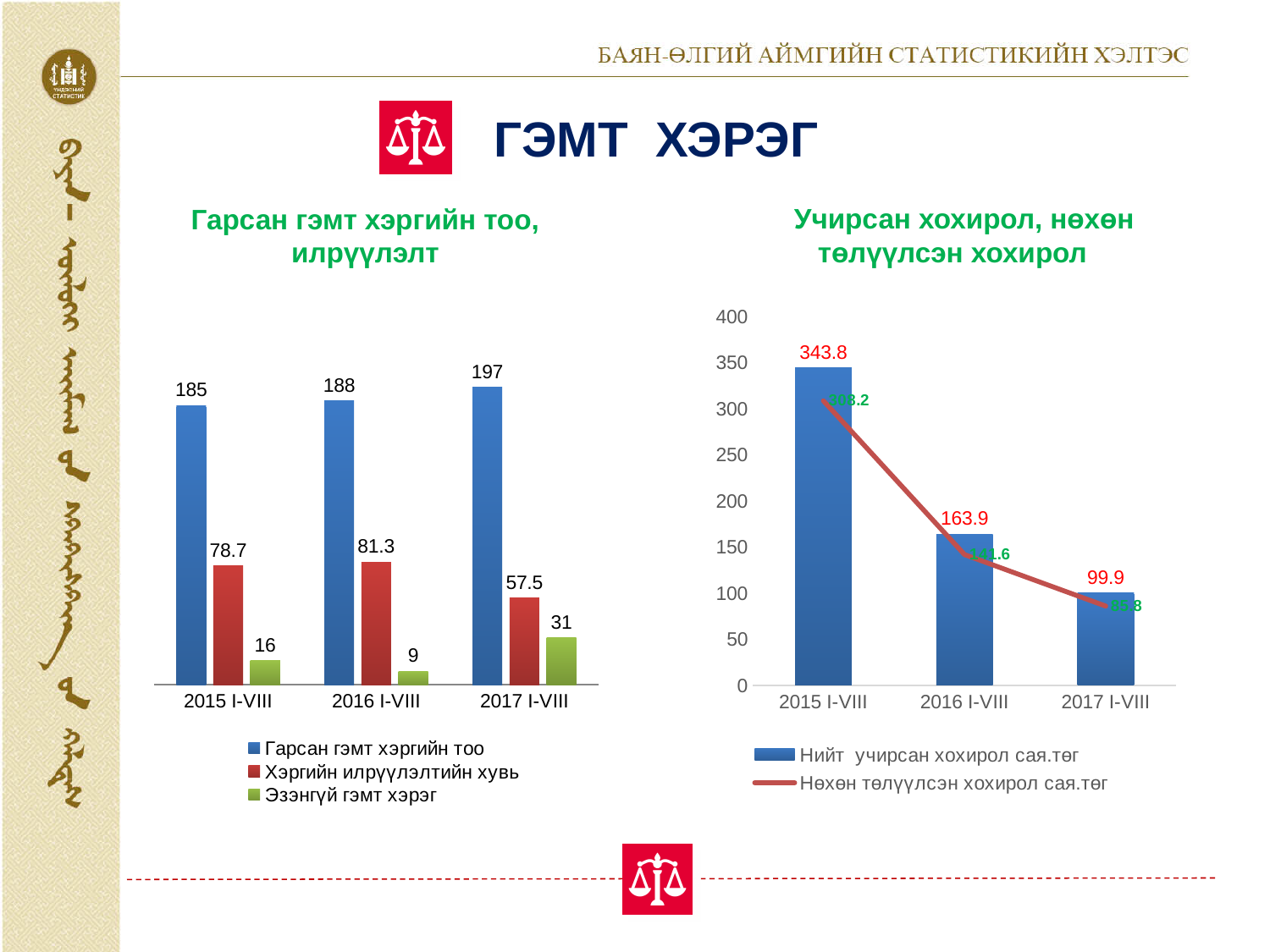
In the left chart 'Гарсан гэмт хэргийн тоо, илрүүлэлт', which period has the lowest value for 'Эзэнгүй гэмт хэрэг'? 2016 I-VIII In the left chart 'Гарсан гэмт хэргийн тоо, илрүүлэлт', what is the value of 'Хэргийн илрүүлэлтийн хувь' for 2016 I-VIII? 81.3 In the right chart 'Учирсан хохирол, нөхөн төлүүлсэн хохирол', is the value of 'Нөхөн төлүүлсэн хохирол сая.төг' for 2016 I-VIII greater or less than 200? less In the left chart 'Гарсан гэмт хэргийн тоо, илрүүлэлт', what is the value of 'Эзэнгүй гэмт хэрэг' for 2015 I-VIII? 16 In the left chart 'Гарсан гэмт хэргийн тоо, илрүүлэлт', how many series does the legend list? 3 In the left chart 'Гарсан гэмт хэргийн тоо, илрүүлэлт', what is the value of 'Гарсан гэмт хэргийн тоо' for 2017 I-VIII? 197 In the right chart 'Учирсан хохирол, нөхөн төлүүлсэн хохирол', what is the value of 'Нийт учирсан хохирол сая.төг' for 2017 I-VIII? 99.9 In the left chart 'Гарсан гэмт хэргийн тоо, илрүүлэлт', does 'Гарсан гэмт хэргийн тоо' rise or fall from 2015 I-VIII to 2017 I-VIII? rise In the right chart 'Учирсан хохирол, нөхөн төлүүлсэн хохирол', what is the value of 'Нийт учирсан хохирол сая.төг' for 2015 I-VIII? 343.8 In the right chart 'Учирсан хохирол, нөхөн төлүүлсэн хохирол', does 'Нийт учирсан хохирол сая.төг' rise or fall across the periods? fall In the left chart 'Гарсан гэмт хэргийн тоо, илрүүлэлт', what is the difference between 'Гарсан гэмт хэргийн тоо' in 2017 I-VIII and 2015 I-VIII? 12 In the right chart 'Учирсан хохирол, нөхөн төлүүлсэн хохирол', what is the difference between 'Нийт учирсан хохирол сая.төг' in 2015 I-VIII and 2016 I-VIII? 179.9